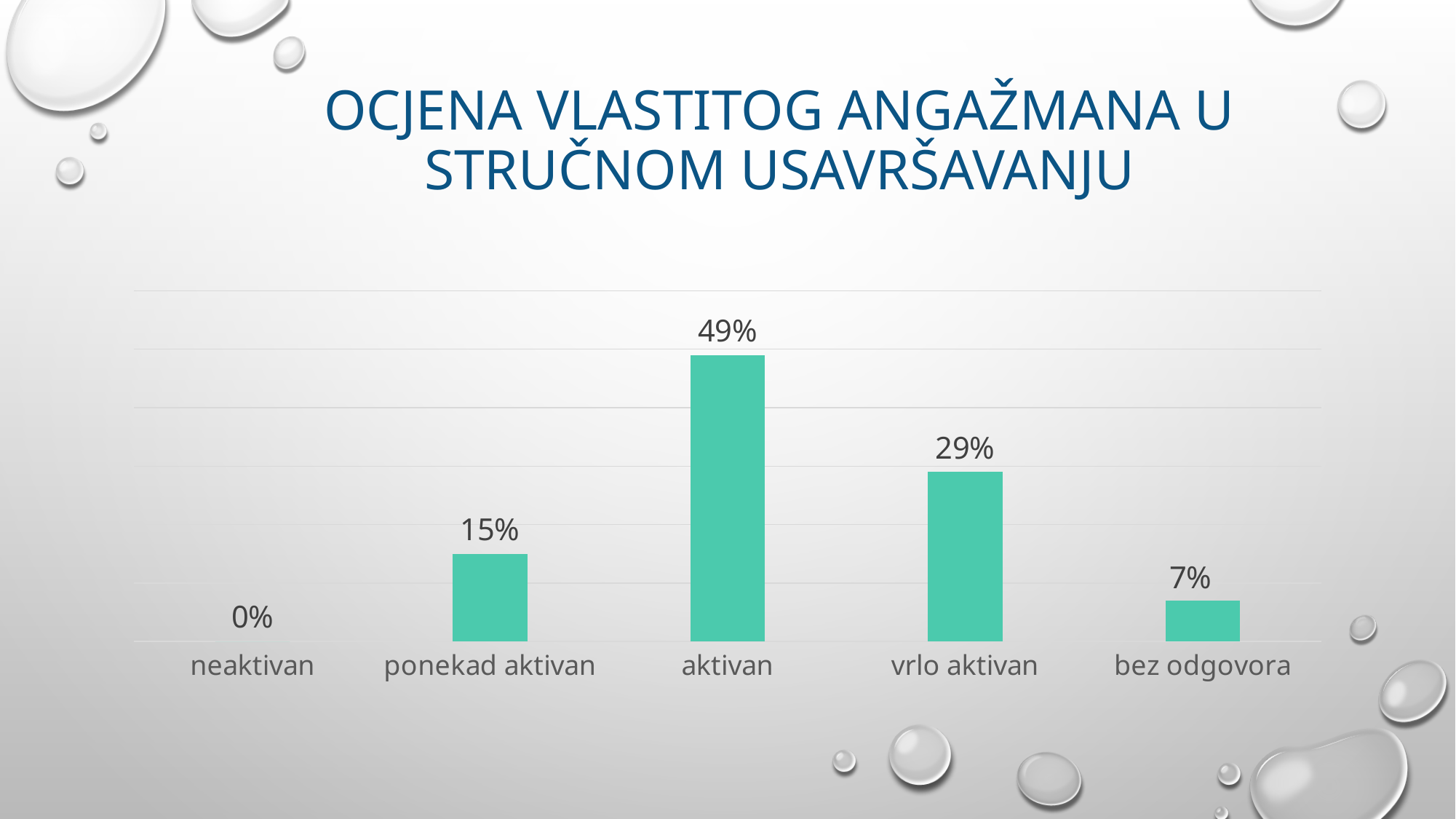
Which is larger, the value for "ponekad aktivan" or the value for "bez odgovora"? ponekad aktivan What is the value for "aktivan"? 49% What is the value for "neaktivan"? 0% What is the title of the chart on the slide? OCJENA VLASTITOG ANGAŽMANA U STRUČNOM USAVRŠAVANJU What is the difference between the values for "aktivan" and "vrlo aktivan"? 20% Which category has the lowest value? neaktivan How many categories are shown on the x axis? 5 What is the value for "bez odgovora"? 7% What is the value for "ponekad aktivan"? 15% What kind of chart is shown on the slide? bar chart Which category has the highest value? aktivan What is the value for "vrlo aktivan"? 29%